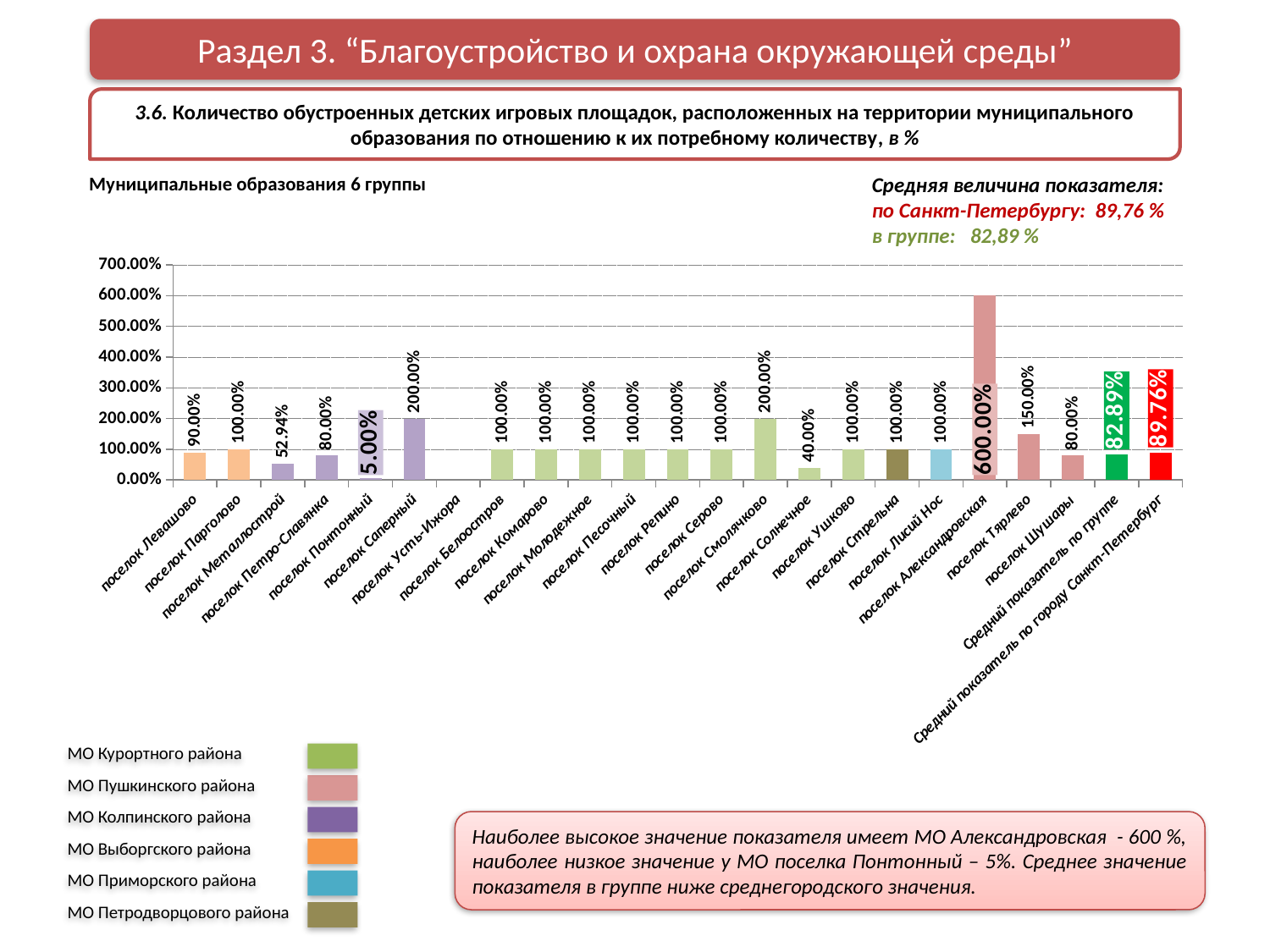
Which is larger, the value for поселок Левашово or the value for поселок Петро-Славянка? поселок Левашово Which category has the highest value? поселок Александровская What is the difference between the values for поселок Александровская and поселок Саперный? 400.00% How many categories are shown on the x axis? 23 What is the value for Средний показатель по группе? 82.89% Is the value for поселок Смолячково greater or less than 100.00%? greater What is the value for поселок Металлострой? 52.94% What is the value for поселок Тярлево? 150.00% What kind of chart is shown on the slide? bar chart What is the value for поселок Солнечное? 40.00% How many district entries does the legend list? 6 Which category has the lowest labelled value? поселок Понтонный